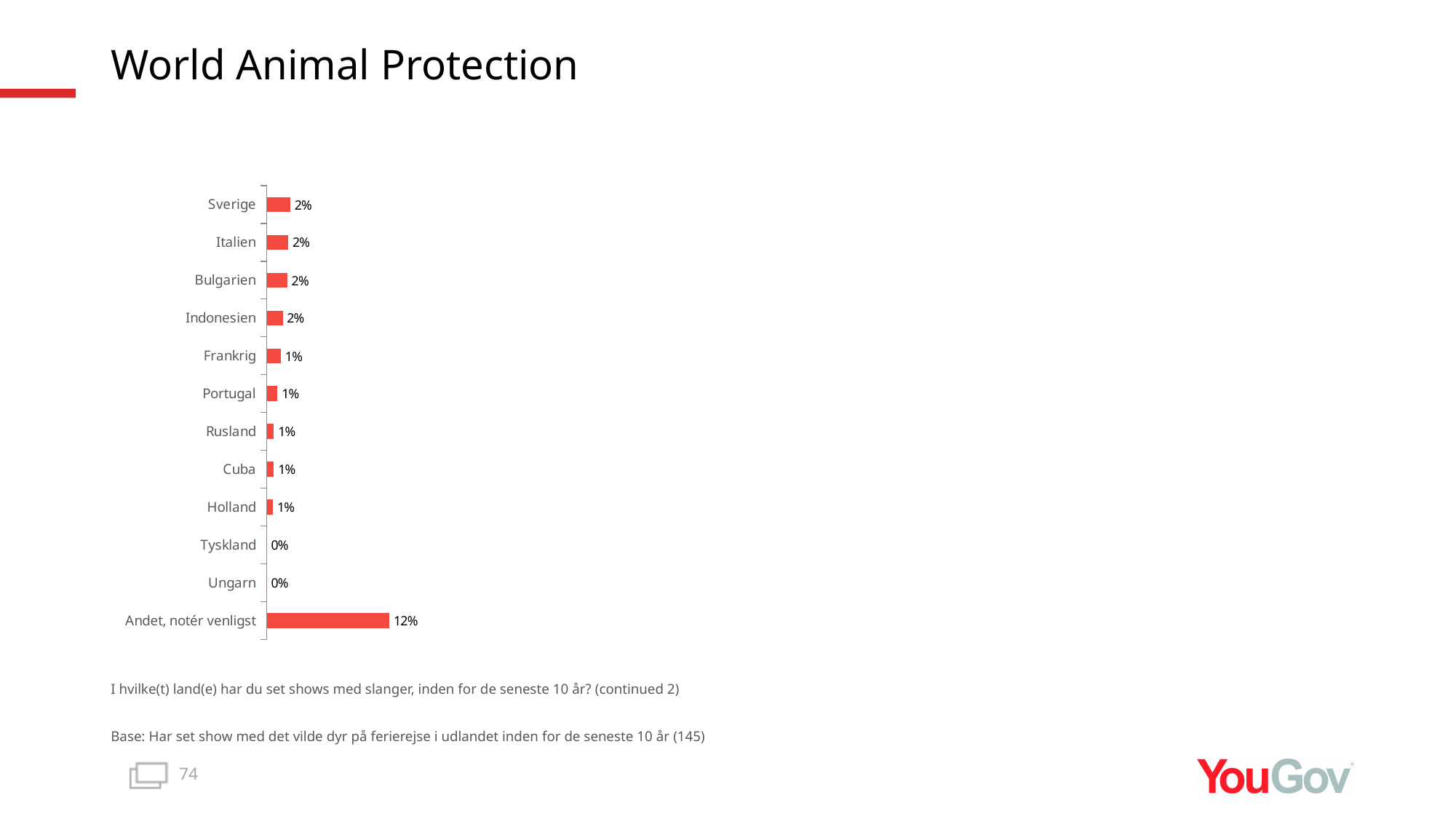
What is the value for Frankrig? 1% Which is larger, the value for Indonesien or the value for Cuba? Indonesien What is the value for Tyskland? 0% How many categories have a value of 0%? 2 How many categories are shown in the chart? 12 What is the value for Sverige? 2% What kind of chart is shown on the slide? Bar chart What is the value for Andet, notér venligst? 12% What is the base size stated below the chart? 145 What is the difference between the values for Andet, notér venligst and Italien? 10% Which category has the highest value? Andet, notér venligst What is the difference between the values for Bulgarien and Portugal? 1%